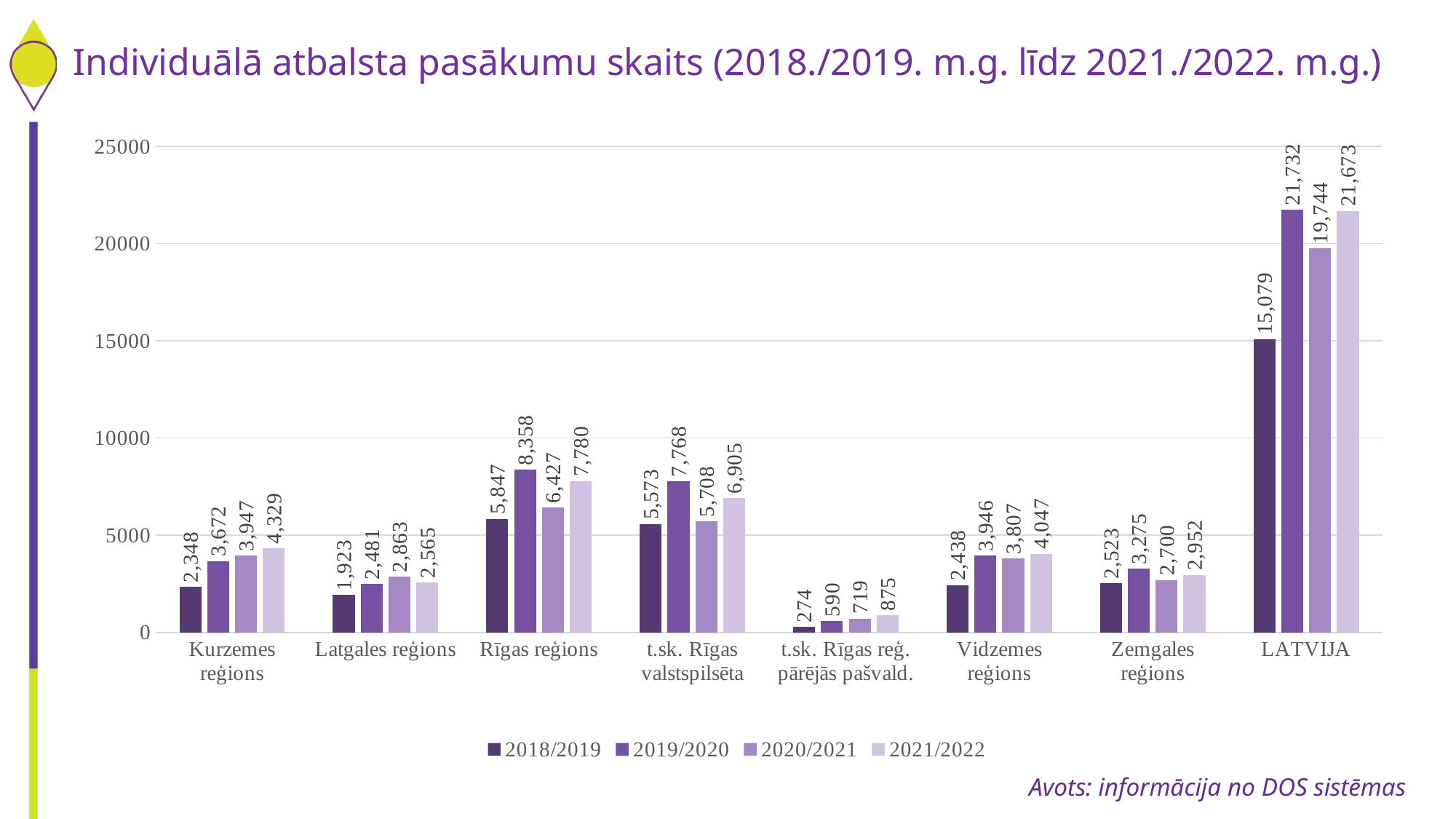
Which is larger for Zemgales reģions: the 2019/2020 value or the 2021/2022 value? 2019/2020 What is the value for Kurzemes reģions in the 2021/2022 series? 4,329 How many series does the legend list? 4 What is the value for t.sk. Rīgas reģ. pārējās pašvald. in the 2019/2020 series? 590 What kind of chart is shown on the slide? bar chart What is the value for LATVIJA in the 2018/2019 series? 15,079 What is the difference between the 2019/2020 and 2018/2019 values for Rīgas reģions? 2,511 Which category has the highest value in the 2021/2022 series? LATVIJA Is the 2020/2021 value for LATVIJA greater or less than 20000? less Do the values for Latgales reģions rise or fall from 2018/2019 to 2020/2021? rise How many categories are shown on the x axis? 8 Which category has the lowest value in the 2020/2021 series? t.sk. Rīgas reģ. pārējās pašvald.